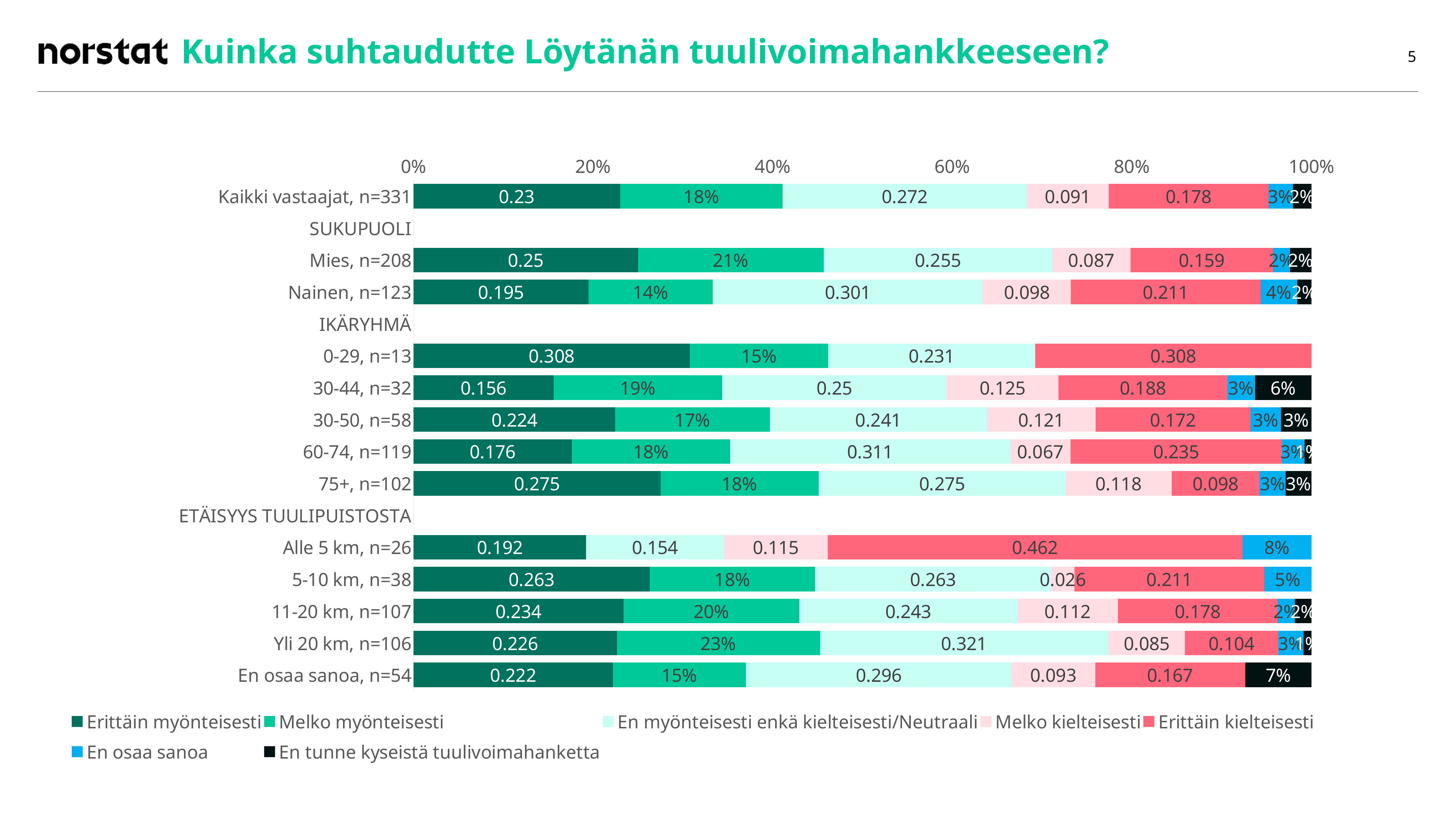
Which has the larger Erittäin myönteisesti value, Mies, n=208 or Nainen, n=123? Mies, n=208 What is the value of Erittäin myönteisesti for Kaikki vastaajat, n=331? 0.23 What kind of chart is shown on the slide? Stacked bar chart Which category has the lowest Erittäin myönteisesti value? 30-44, n=32 What is the value of Melko myönteisesti for Mies, n=208? 21% How many series does the legend list? 7 What is the difference between the Melko myönteisesti values for Mies, n=208 and Nainen, n=123? 7% Which category has the highest Erittäin kielteisesti value? Alle 5 km, n=26 What is the value of Erittäin kielteisesti for Alle 5 km, n=26? 0.462 What is the value of En tunne kyseistä tuulivoimahanketta for 30-44, n=32? 6% What is the value of En myönteisesti enkä kielteisesti/Neutraali for Nainen, n=123? 0.301 What is the value of En osaa sanoa for Alle 5 km, n=26? 8%